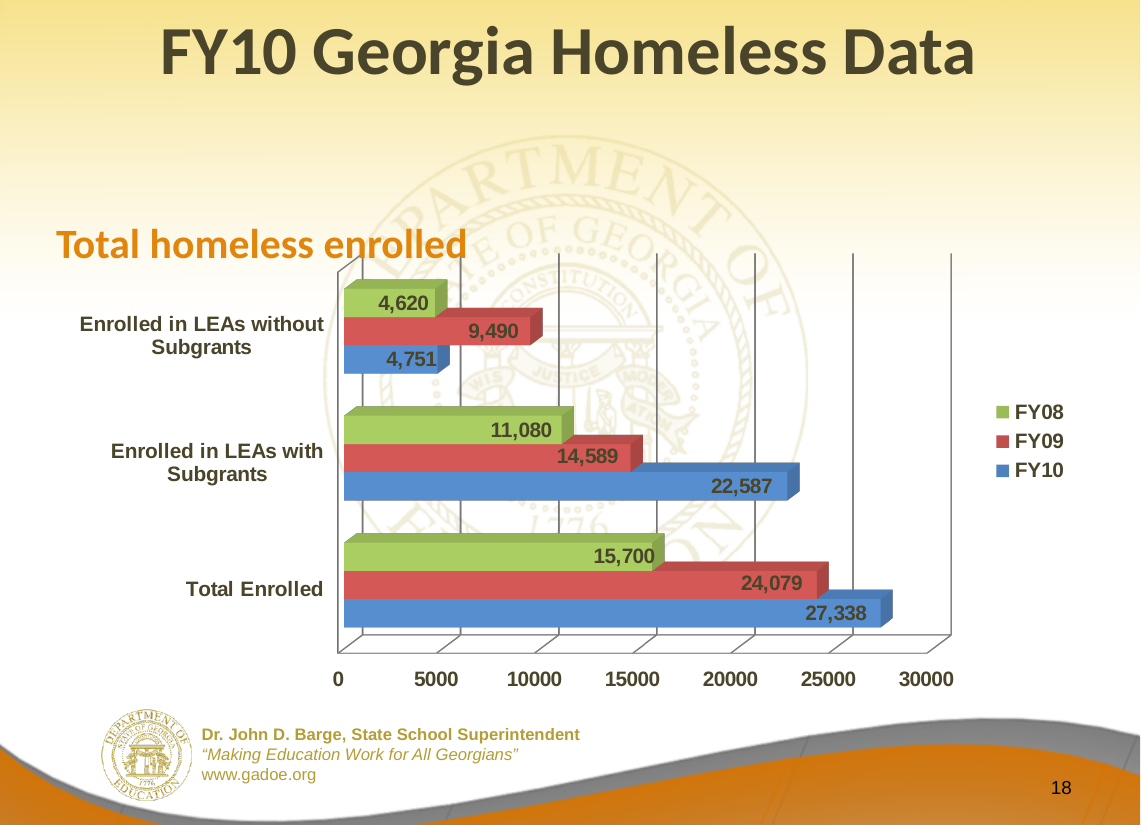
Which is larger for Enrolled in LEAs without Subgrants: the FY09 value or the FY10 value? FY09 What is the FY08 value for Enrolled in LEAs with Subgrants? 11,080 Which category has the lowest FY08 value? Enrolled in LEAs without Subgrants Which category has the highest FY10 value? Total Enrolled Is the FY10 value for Enrolled in LEAs with Subgrants greater or less than 20000? greater What is the title of the chart? Total homeless enrolled What is the difference between the FY10 and FY09 values for Total Enrolled? 3,259 How many categories are shown on the chart? 3 How many series does the legend list? 3 What kind of chart is shown on the slide? Bar chart What is the FY09 value for Enrolled in LEAs without Subgrants? 9,490 What is the FY10 value for Total Enrolled? 27,338